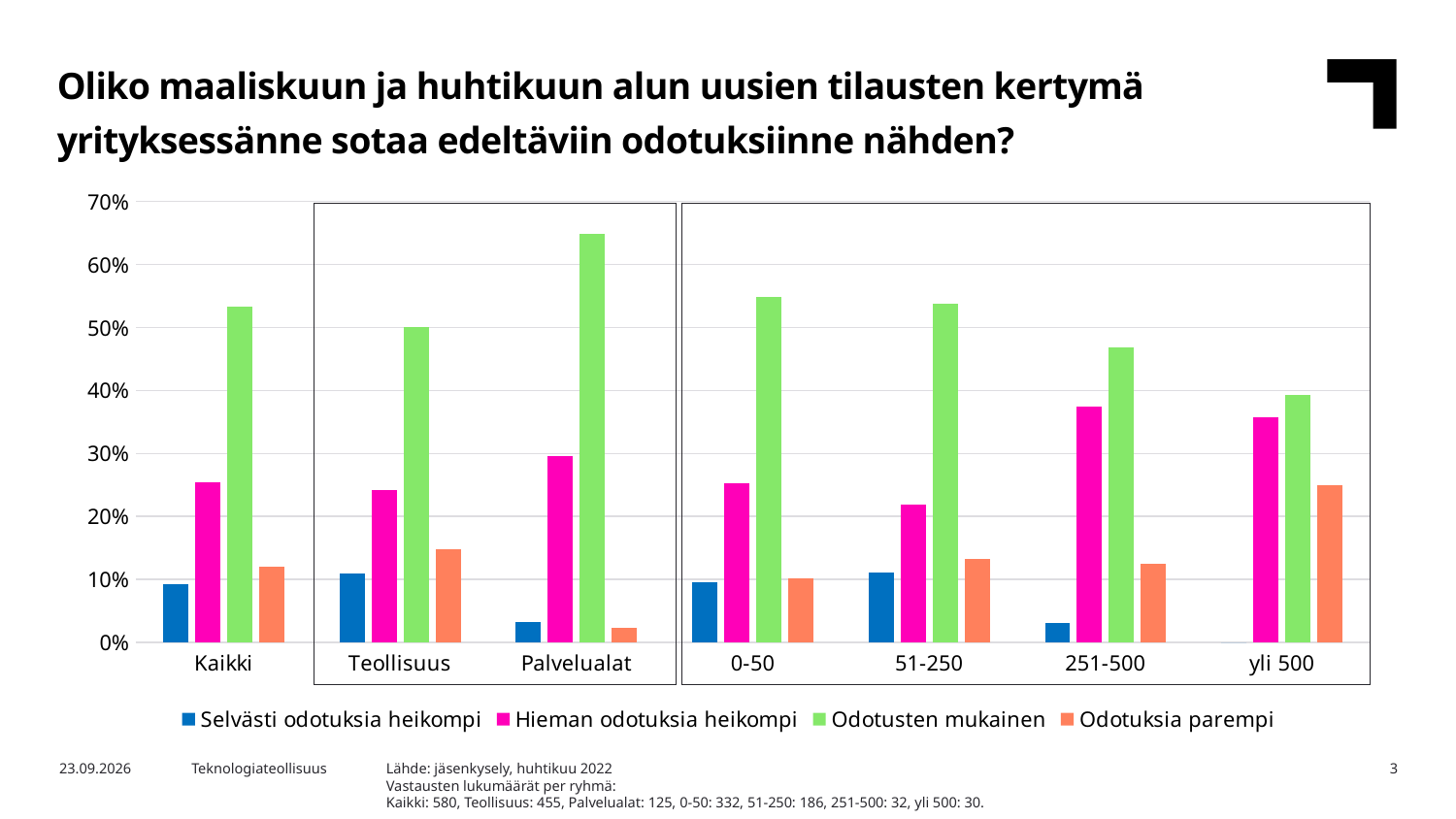
What kind of chart is shown on the slide? bar chart In the Kaikki category, which is larger: 'Hieman odotuksia heikompi' or 'Odotuksia parempi'? Hieman odotuksia heikompi How many categories are shown on the x axis? 7 Is the value for 'Odotuksia parempi' in yli 500 greater or less than 20%? greater Which colour represents the series 'Odotusten mukainen' in the legend? green Is the value for 'Hieman odotuksia heikompi' in 251-500 greater or less than 30%? greater Which category has the highest value for 'Odotusten mukainen'? Palvelualat How many series does the legend list? 4 Is the value for 'Odotusten mukainen' in Kaikki greater or less than 50%? greater Which category has the lowest value for 'Odotusten mukainen'? yli 500